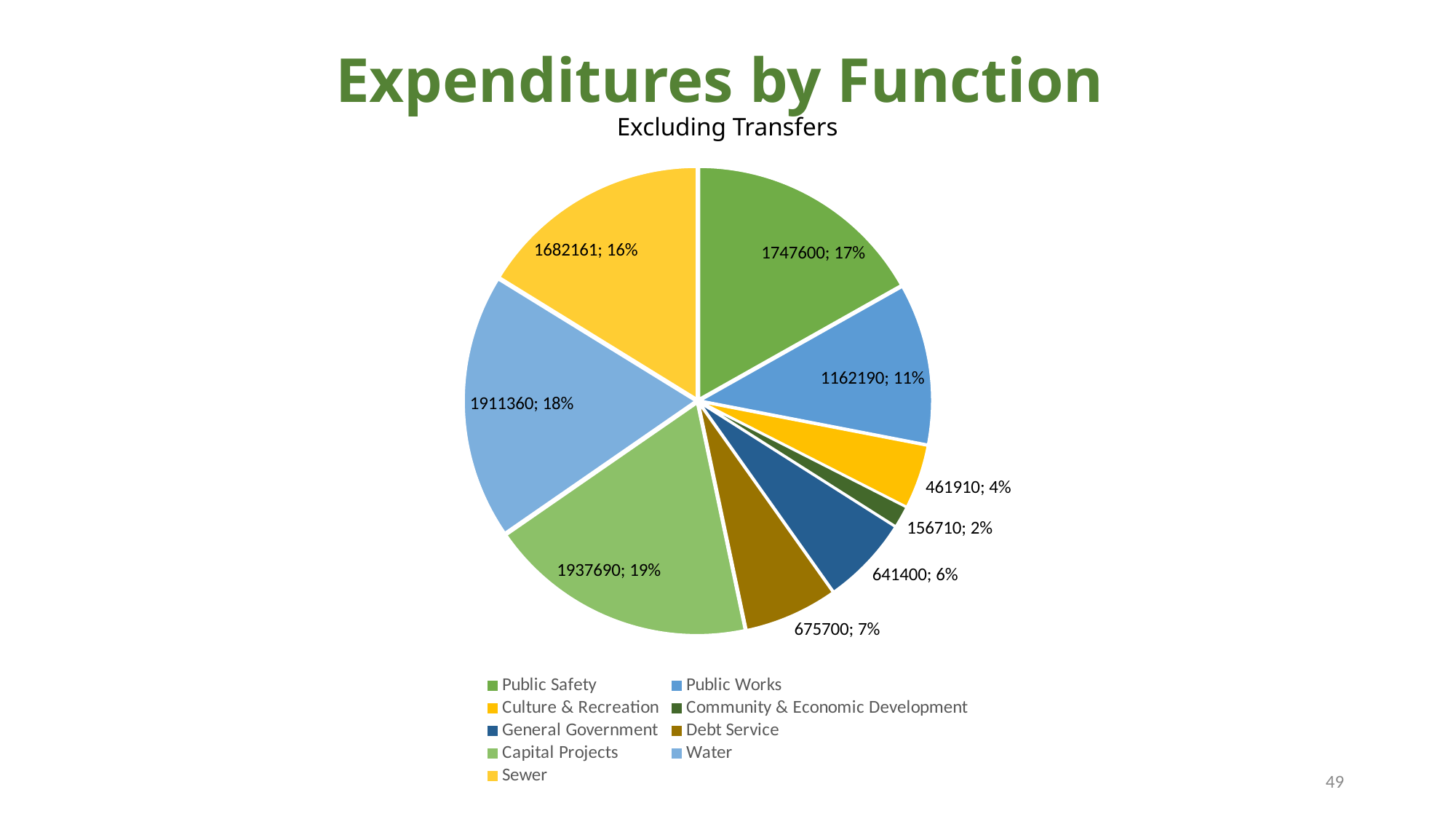
Which is larger, the value for General Government or the value for Debt Service? Debt Service What is the subtitle shown under the chart title? Excluding Transfers How many categories are shown in the pie chart? 9 What share of the pie does Water represent? 18% Which category has the smallest slice? Community & Economic Development What is the difference between the values for Public Safety and Public Works? 585410 What is the value for Public Safety? 1747600 What share of the pie does Community & Economic Development represent? 2% Which category has the largest slice? Capital Projects What is the value for Sewer? 1682161 What is the value for Debt Service? 675700 What kind of chart is shown on the slide? Pie chart